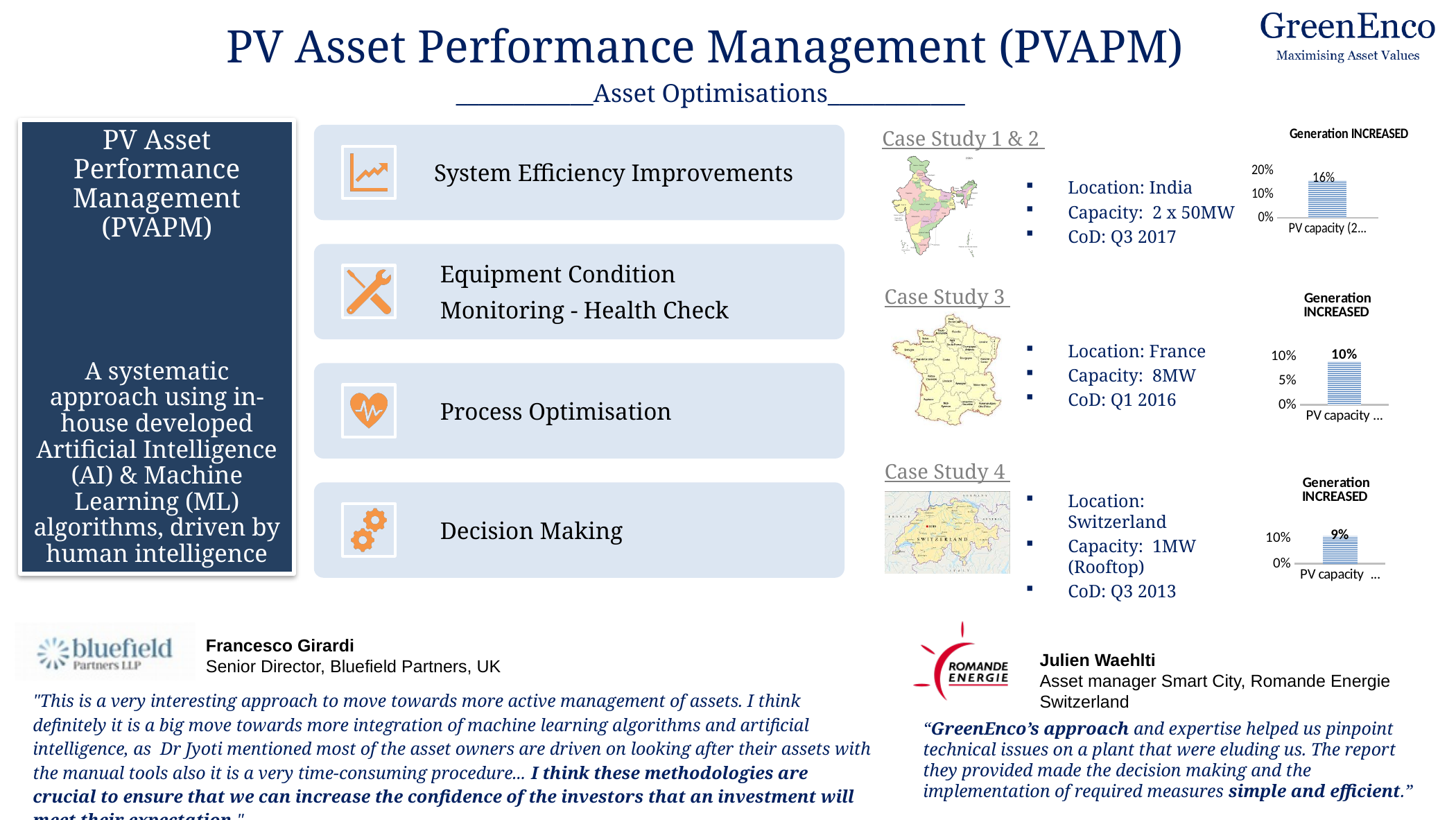
Is the bar value in the Case Study 1 & 2 chart greater or less than 10%? greater What is the highest y-axis tick shown in the chart next to Case Study 1 & 2? 20% What is the difference between the bar value in the Case Study 1 & 2 chart and the bar value in the Case Study 4 chart? 7% What type of chart is shown next to Case Study 1 & 2? Bar chart What is the title of the chart next to Case Study 3? Generation INCREASED Is the bar value in the Case Study 4 chart greater or less than 10%? less In the chart next to Case Study 1 & 2 (top right), what value is shown on the bar? 16% How many bars are plotted in the chart next to Case Study 4? 1 Which is larger: the bar value in the Case Study 1 & 2 chart or the bar value in the Case Study 3 chart? Case Study 1 & 2 chart In the chart next to Case Study 4 (bottom right), what value is shown on the bar? 9% What is the difference between the bar value in the Case Study 3 chart and the bar value in the Case Study 4 chart? 1% In the chart next to Case Study 3 (middle right), what value is shown on the bar? 10%